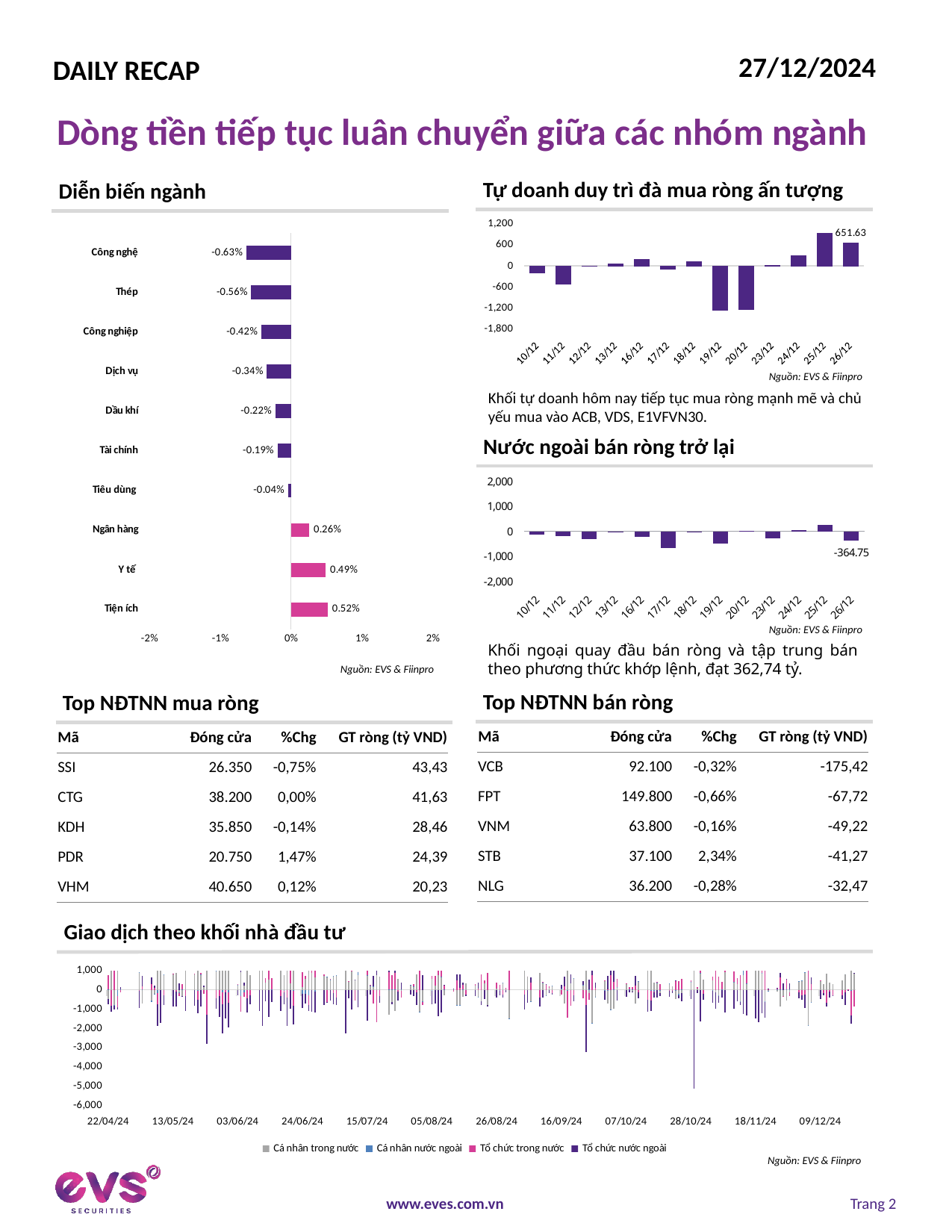
How many sectors are shown in the 'Diễn biến ngành' chart? 10 In the 'Nước ngoài bán ròng trở lại' chart, what is the value for 26/12? -364.75 In the 'Diễn biến ngành' chart, which sector has the lowest value? Công nghệ In the 'Diễn biến ngành' chart, which sector has the highest value? Tiện ích How many dates are shown on the x axis of the 'Nước ngoài bán ròng trở lại' chart? 13 In the 'Diễn biến ngành' chart, what is the difference between the values for Y tế and Ngân hàng? 0.23% In the 'Diễn biến ngành' chart, what is the value for Tiện ích? 0.52% In the 'Tự doanh duy trì đà mua ròng ấn tượng' chart, what is the value for 26/12? 651.63 In the 'Diễn biến ngành' chart, what is the value for Công nghệ? -0.63% How many series does the legend of the 'Giao dịch theo khối nhà đầu tư' chart list? 4 In the 'Tự doanh duy trì đà mua ròng ấn tượng' chart, is the value for 19/12 greater or less than -600? less In the 'Diễn biến ngành' chart, which has a larger value, Thép or Dịch vụ? Dịch vụ